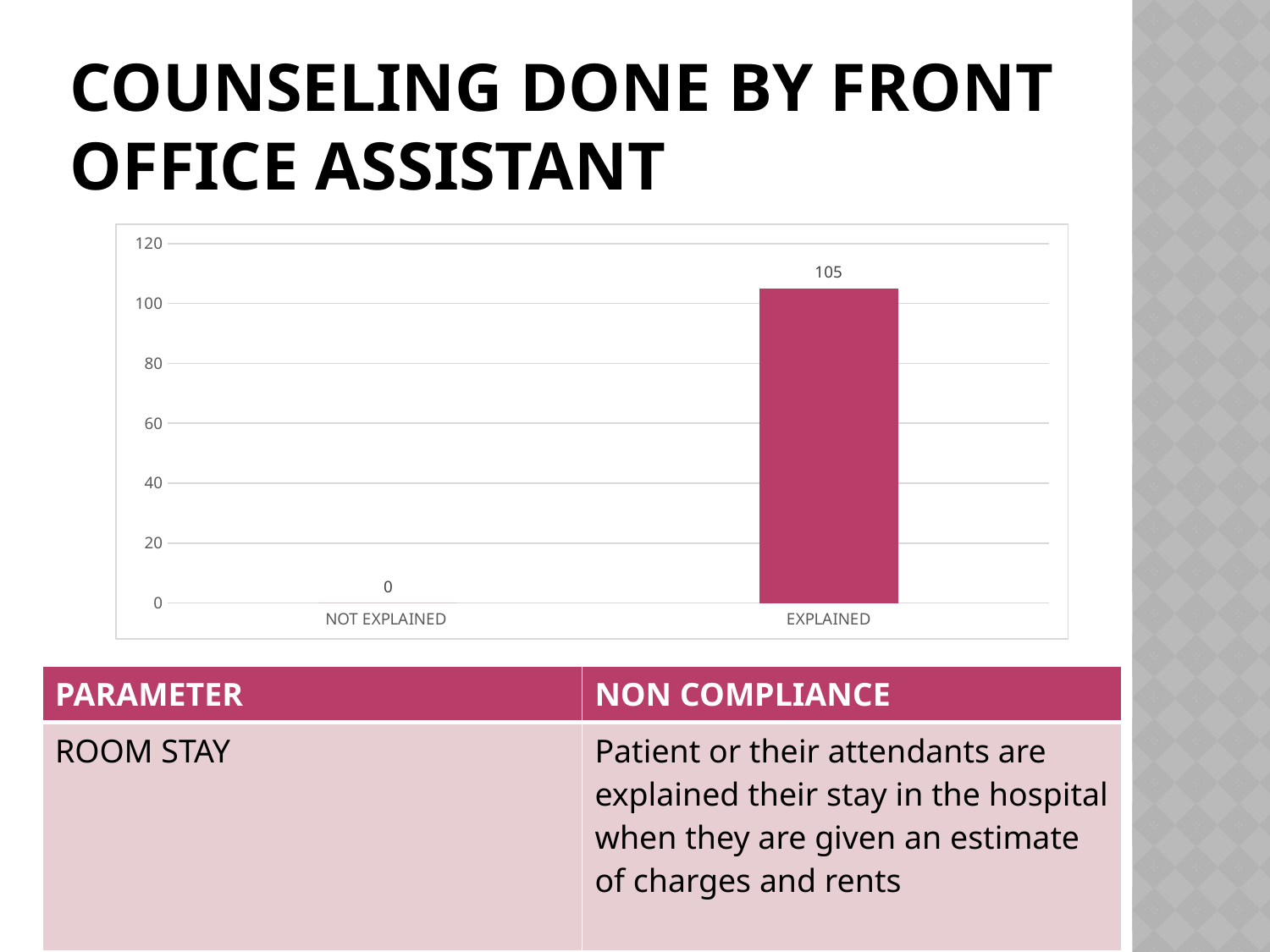
What is the difference between the values for EXPLAINED and NOT EXPLAINED? 105 What kind of chart is shown on the slide? bar chart Is the value for EXPLAINED greater or less than 100? greater What is the value for NOT EXPLAINED? 0 How many categories are shown on the x axis of the chart? 2 What is the value for EXPLAINED? 105 What is the total of the two values shown in the chart? 105 Which category has the highest value? EXPLAINED What is the highest value shown on the y axis of the chart? 120 Which category has the lowest value? NOT EXPLAINED What colour are the bars in the chart? magenta/pink Which is larger, the value for EXPLAINED or the value for NOT EXPLAINED? EXPLAINED